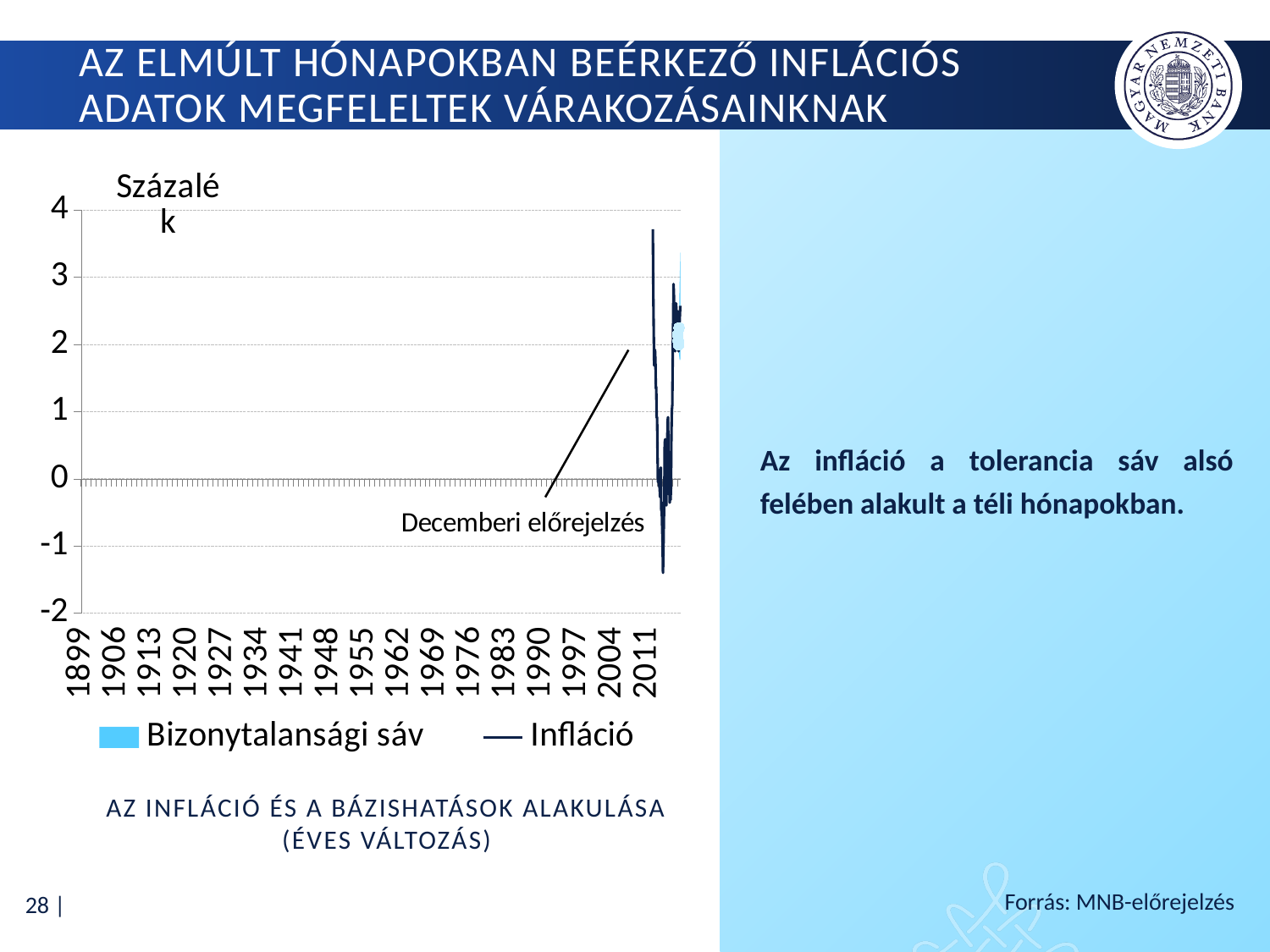
Is the highest point of the Infláció line greater or less than 3? greater What is the title printed below the chart? AZ INFLÁCIÓ ÉS A BÁZISHATÁSOK ALAKULÁSA (ÉVES VÁLTOZÁS) What kind of chart is shown on the slide? line chart Is the lowest point of the Infláció line greater or less than -1? less What are the two entries in the chart's legend? Bizonytalansági sáv, Infláció How many series does the legend of the chart list? 2